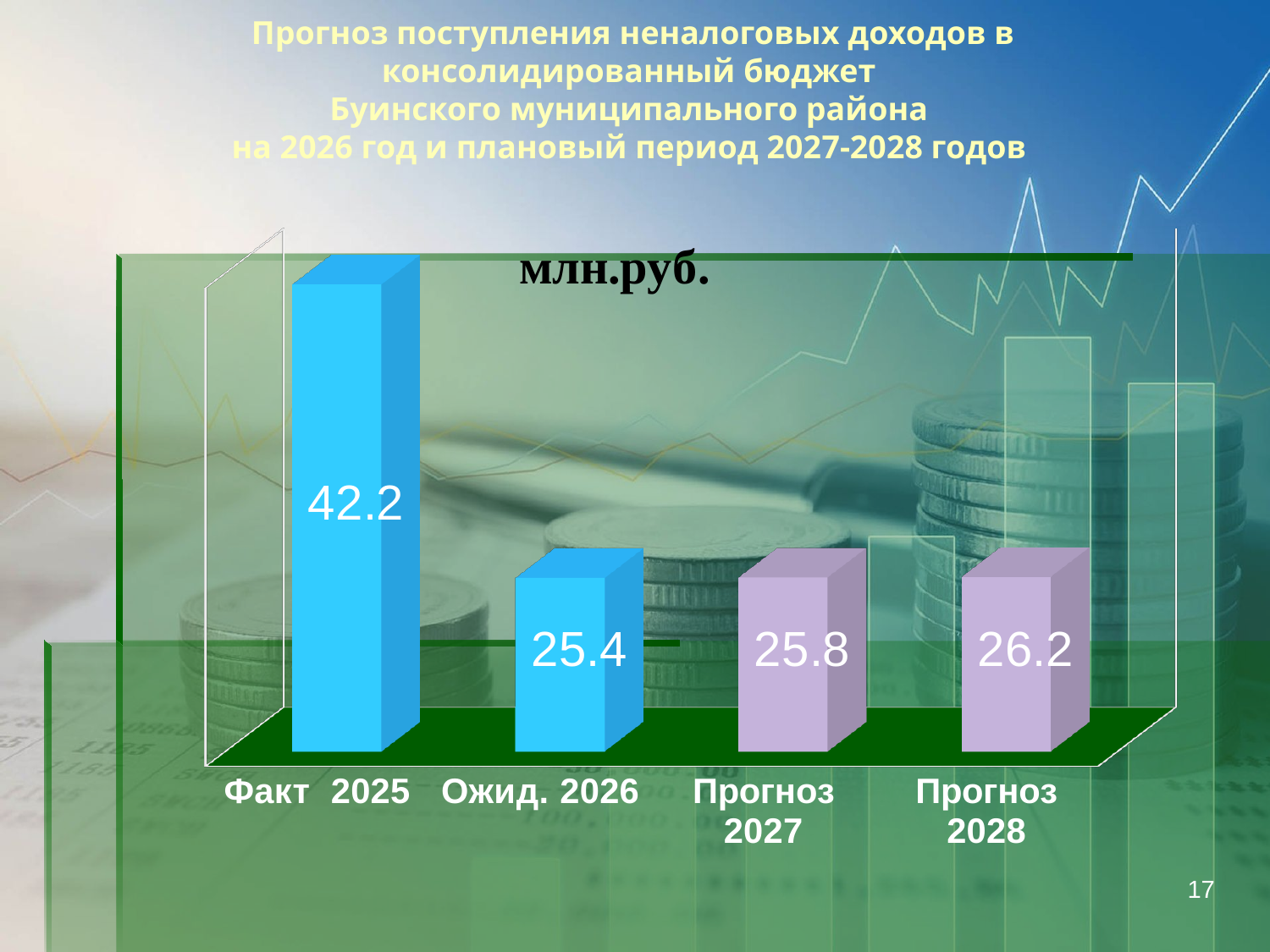
What is the value for Факт 2025? 42.2 How many categories are shown in the chart? 4 What is the difference between the values for Факт 2025 and Ожид. 2026? 16.8 Which category has the highest value? Факт 2025 What unit label is shown above the chart? млн.руб. Which category has the lowest value? Ожид. 2026 What kind of chart is shown on the slide? Bar chart What is the value for Прогноз 2027? 25.8 What is the difference between the values for Прогноз 2028 and Прогноз 2027? 0.4 What is the value for Прогноз 2028? 26.2 What is the value for Ожид. 2026? 25.4 Which is larger, the value for Факт 2025 or the value for Прогноз 2028? Факт 2025